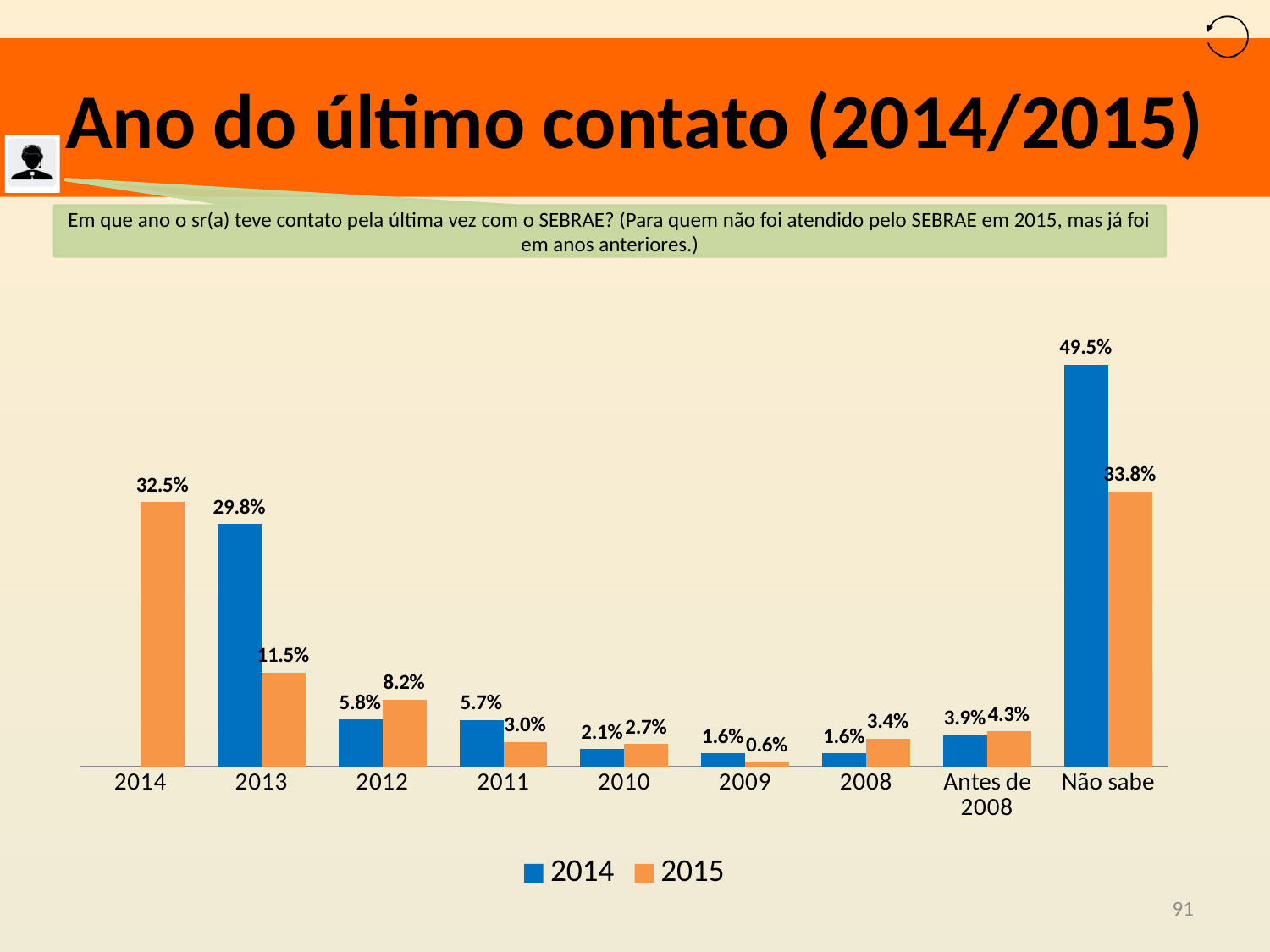
For the category 2012, which series has the larger value, 2014 or 2015? 2015 What kind of chart is shown on the slide? Bar chart What is the 2014 value for the category 2013? 29.8% What is the 2015 value for "Não sabe"? 33.8% How many categories are shown on the x axis? 9 What is the 2015 value for the category 2014? 32.5% Which category has the lowest value in the 2015 series? 2009 Which category has the highest value in the 2014 series? Não sabe What is the 2014 value for "Antes de 2008"? 3.9% What is the difference between the 2014 and 2015 values for the category 2013? 18.3% What is the difference between the 2014 and 2015 values for "Não sabe"? 15.7% How many series does the legend list? 2